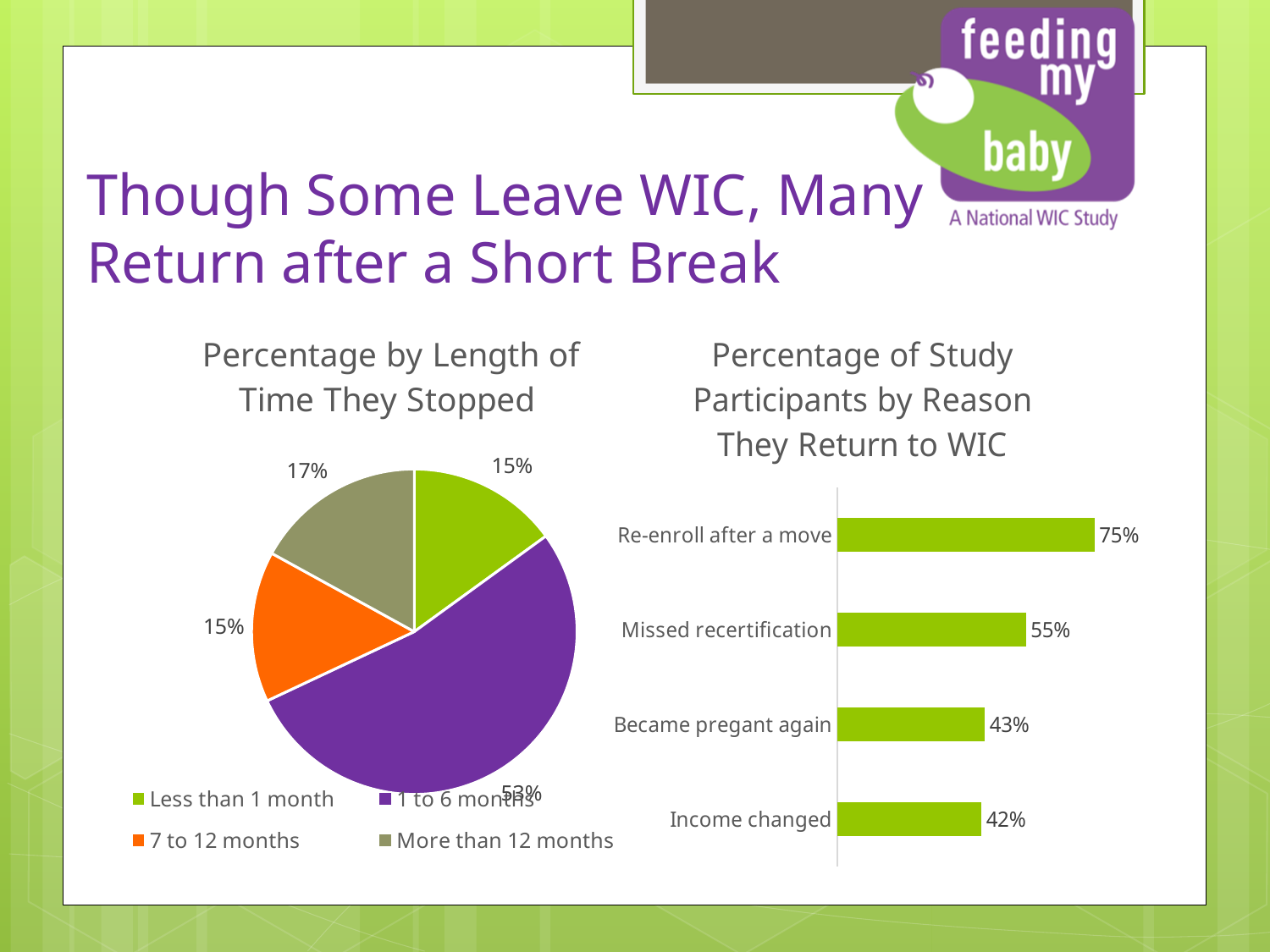
In the pie chart "Percentage by Length of Time They Stopped", what share is shown for "1 to 6 months"? 53% In the bar chart "Percentage of Study Participants by Reason They Return to WIC", what is the difference between "Re-enroll after a move" and "Missed recertification"? 20% In the chart titled "Percentage by Length of Time They Stopped", what kind of chart is shown? Pie chart In the pie chart "Percentage by Length of Time They Stopped", what share is shown for "More than 12 months"? 17% In the pie chart "Percentage by Length of Time They Stopped", how many slices does the pie have? 4 In the bar chart "Percentage of Study Participants by Reason They Return to WIC", what is the value for "Missed recertification"? 55% In the chart titled "Percentage of Study Participants by Reason They Return to WIC", what kind of chart is shown? Bar chart In the bar chart "Percentage of Study Participants by Reason They Return to WIC", which reason has the highest value? Re-enroll after a move In the bar chart "Percentage of Study Participants by Reason They Return to WIC", how many reasons are listed? 4 In the bar chart "Percentage of Study Participants by Reason They Return to WIC", which reason has the lowest value? Income changed In the pie chart "Percentage by Length of Time They Stopped", which category has the largest slice? 1 to 6 months In the bar chart "Percentage of Study Participants by Reason They Return to WIC", what is the value for "Income changed"? 42%